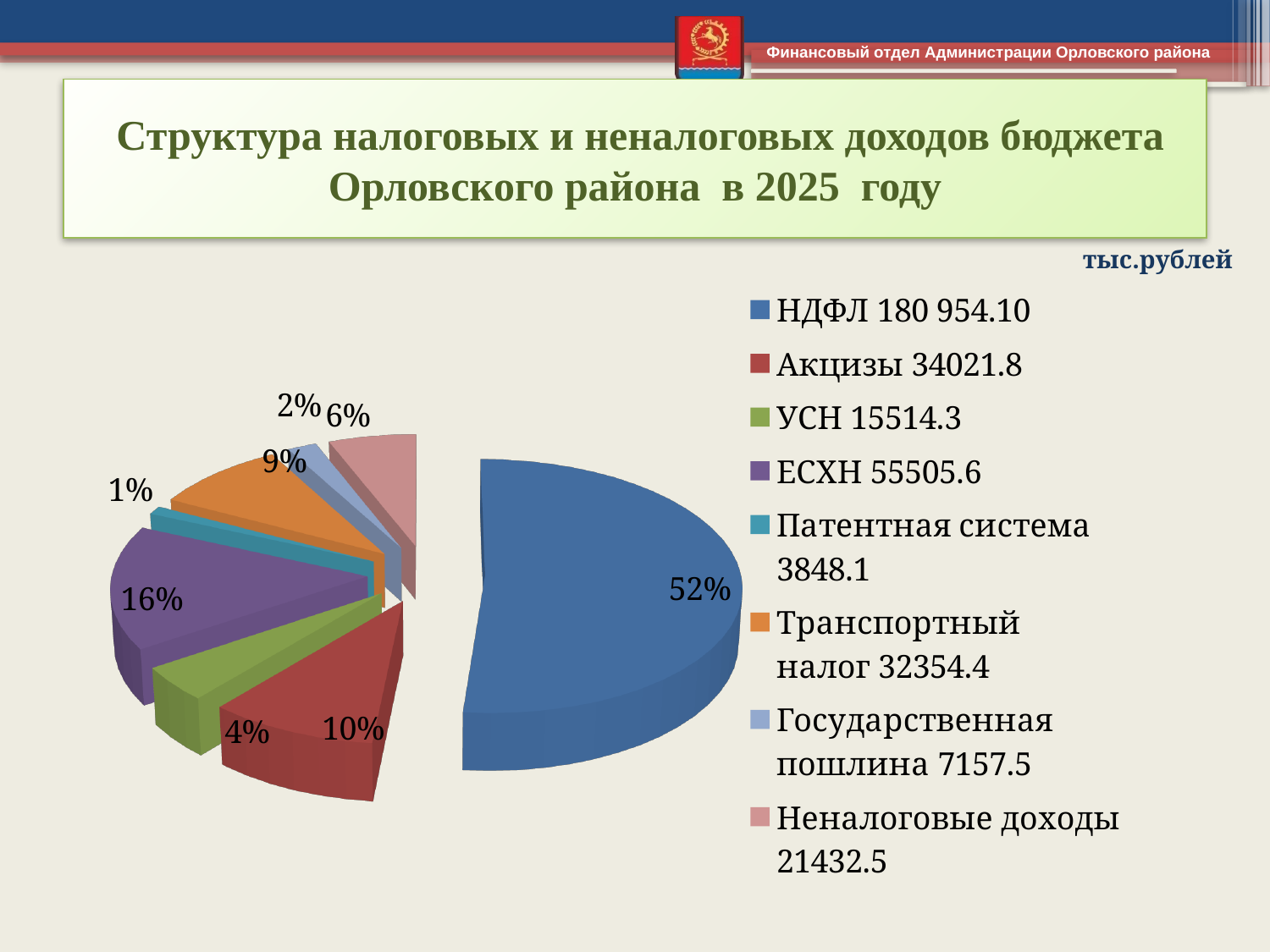
What share of the pie does НДФЛ represent? 52% What share of the pie does Транспортный налог represent? 9% Which category has the largest slice of the pie? НДФЛ What value is shown in the legend for Неналоговые доходы? 21432.5 How many slices does the pie chart have? 8 What kind of chart is shown on the slide? pie chart What share of the pie does ЕСХН represent? 16% What value is shown in the legend for Акцизы? 34021.8 Which category has the smallest slice of the pie? Патентная система Which is larger, the value for Акцизы or the value for Транспортный налог? Акцизы What is the difference between the values for ЕСХН and УСН? 39991.3 In what units are the values on the slide given? тыс.рублей